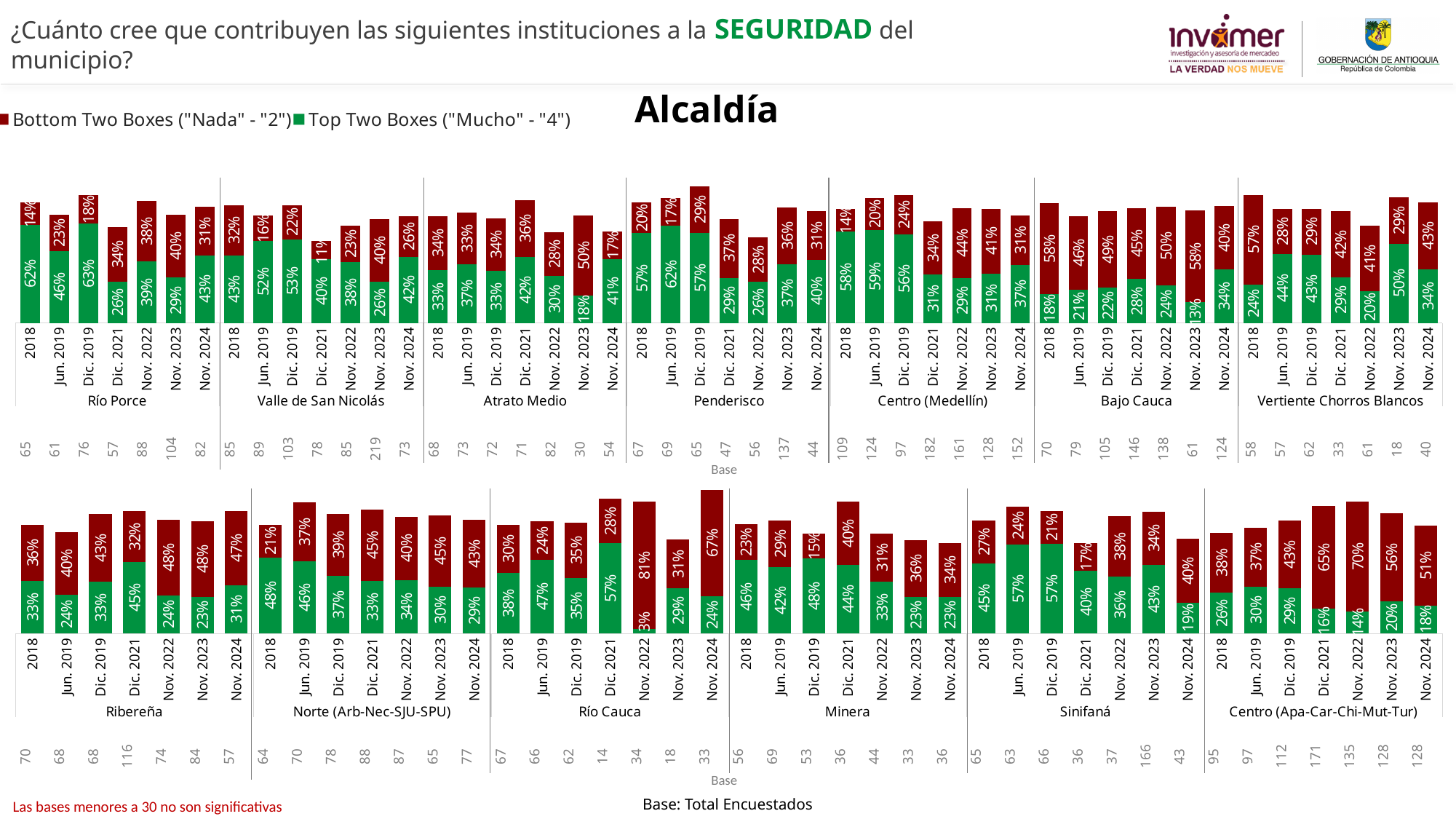
What kind of chart is used on this slide? Stacked bar chart In the bottom chart, which period has the lowest Top Two Boxes value for Río Cauca? Nov. 2022 In the top chart, which is larger for Atrato Medio in Nov. 2023: the Bottom Two Boxes value or the Top Two Boxes value? Bottom Two Boxes In the top chart, which period has the highest Top Two Boxes value for Valle de San Nicolás? Dic. 2019 How many regions are shown in the bottom chart? 6 In the bottom chart, what is the Bottom Two Boxes value for Río Cauca in Nov. 2022? 81% How many series does the legend list? 2 In the top chart, what is the Bottom Two Boxes value for Bajo Cauca in Nov. 2023? 58% In the top chart, what is the Top Two Boxes value for Río Porce in 2018? 62% In the bottom chart, what is the difference between the Bottom Two Boxes and Top Two Boxes values for Centro (Apa-Car-Chi-Mut-Tur) in Nov. 2022? 56 percentage points In the top chart, what is the total of the stacked bar for Penderisco in Dic. 2019? 86% In the bottom chart, what is the Top Two Boxes value for Sinifaná in Jun. 2019? 57%